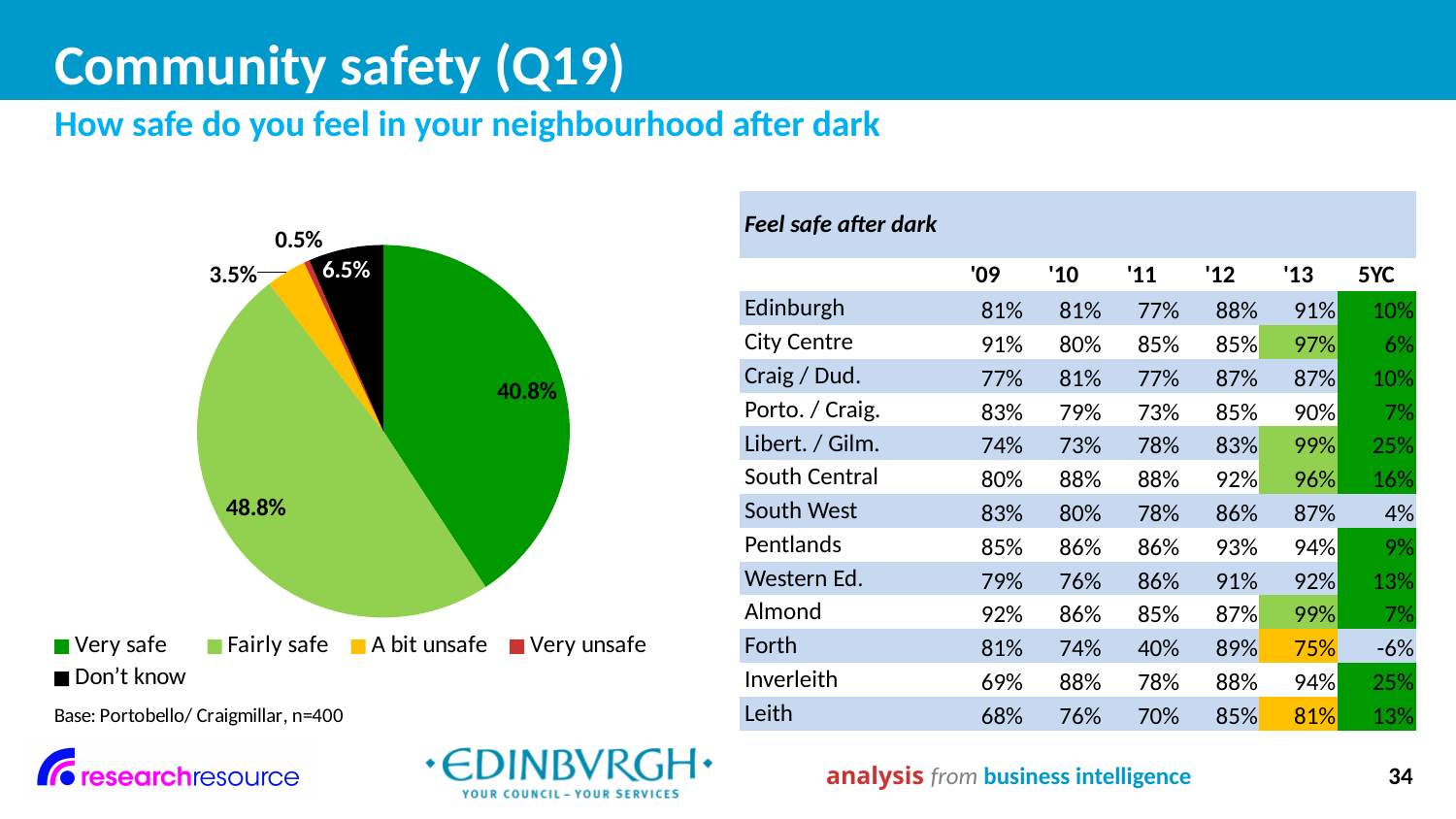
What share of the pie chart is labelled 'Don't know'? 6.5% What share of the pie chart is labelled 'Very unsafe'? 0.5% What is the difference between the 'Fairly safe' and 'Very safe' shares in the pie chart? 8.0% What type of chart is shown on the left of the slide? Pie chart Which category has the largest slice of the pie chart? Fairly safe What colour is the 'Very safe' slice in the pie chart? Dark green Which is larger in the pie chart, 'Don't know' or 'A bit unsafe'? Don't know What share of the pie chart is labelled 'Fairly safe'? 48.8% What share of the pie chart is labelled 'Very safe'? 40.8% Which category has the smallest slice of the pie chart? Very unsafe What share of the pie chart is labelled 'A bit unsafe'? 3.5% How many categories does the pie chart's legend list? 5